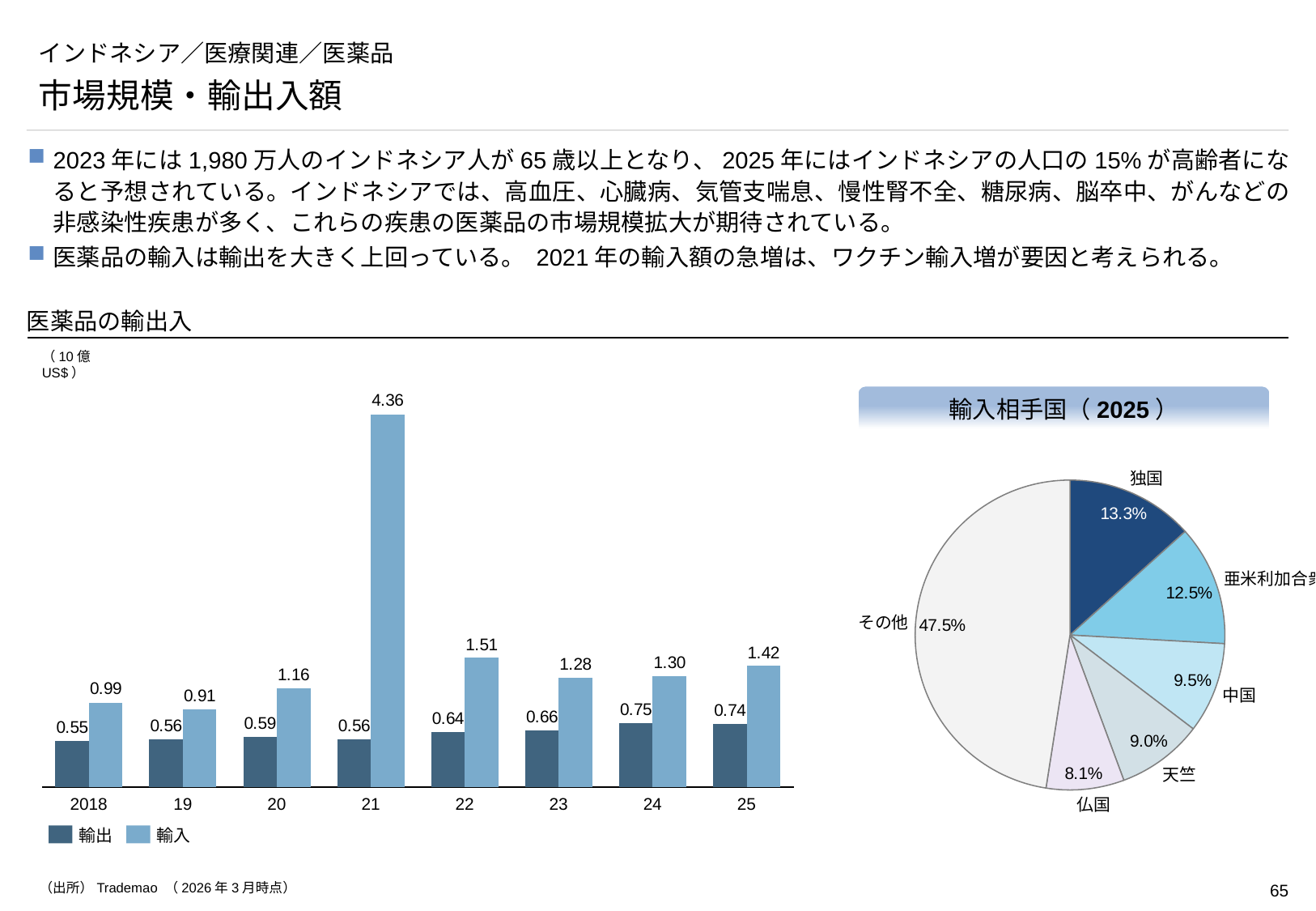
In the bar chart 医薬品の輸出入, what is the value of 輸出 in 2024? 0.75 In the bar chart 医薬品の輸出入, how many years are shown on the x axis? 8 In the pie chart 輸入相手国（2025）, what is the difference between the shares of 中国 and 天竺? 0.5% In the bar chart 医薬品の輸出入, what is the difference between 輸入 and 輸出 in 2025? 0.68 In the pie chart 輸入相手国（2025）, which named country slice is the smallest? 仏国 In the bar chart 医薬品の輸出入, which is larger in 2022: 輸出 or 輸入? 輸入 What kind of chart is 医薬品の輸出入? Bar chart In the pie chart 輸入相手国（2025）, what share does 独国 have? 13.3% In the bar chart 医薬品の輸出入, what is the value of 輸入 in 2021? 4.36 In the bar chart 医薬品の輸出入, how many series does the legend list? 2 In the bar chart 医薬品の輸出入, which year has the highest 輸入 value? 21 In the bar chart 医薬品の輸出入, which year has the lowest 輸入 value? 19